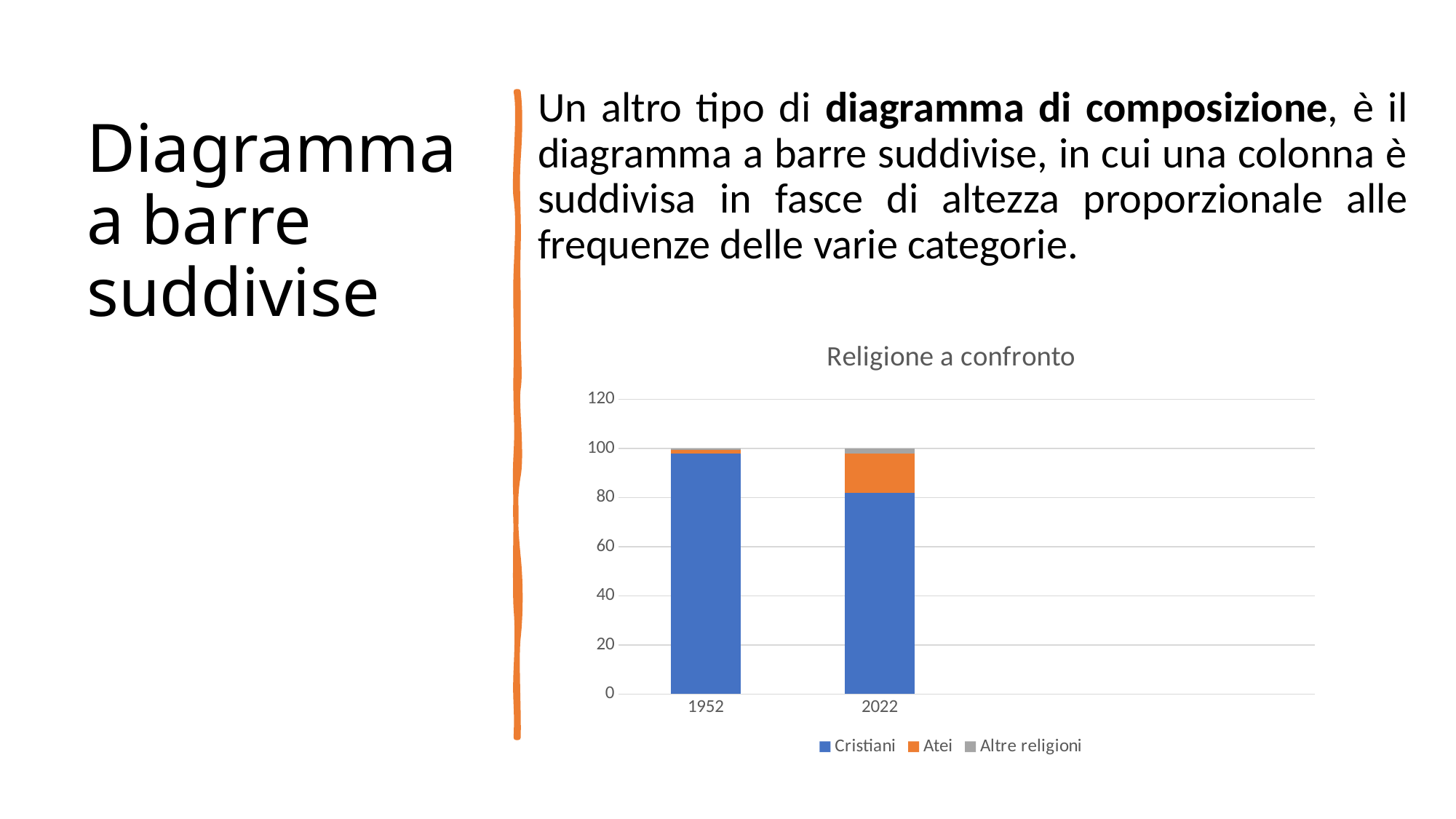
Does the Cristiani value rise or fall from 1952 to 2022? fall What is the title of the chart? Religione a confronto Is the Cristiani value for 2022 greater or less than 100? less Is the Cristiani value larger in 1952 or in 2022? 1952 Which series has the largest value in the 2022 bar? Cristiani Is the Cristiani value for 1952 greater or less than 80? greater Which series are listed in the chart's legend? Cristiani, Atei, Altre religioni Is the Atei value larger in 1952 or in 2022? 2022 How many categories are shown on the x axis of the chart? 2 What kind of chart is shown on the slide? Stacked bar chart How many series does the chart's legend list? 3